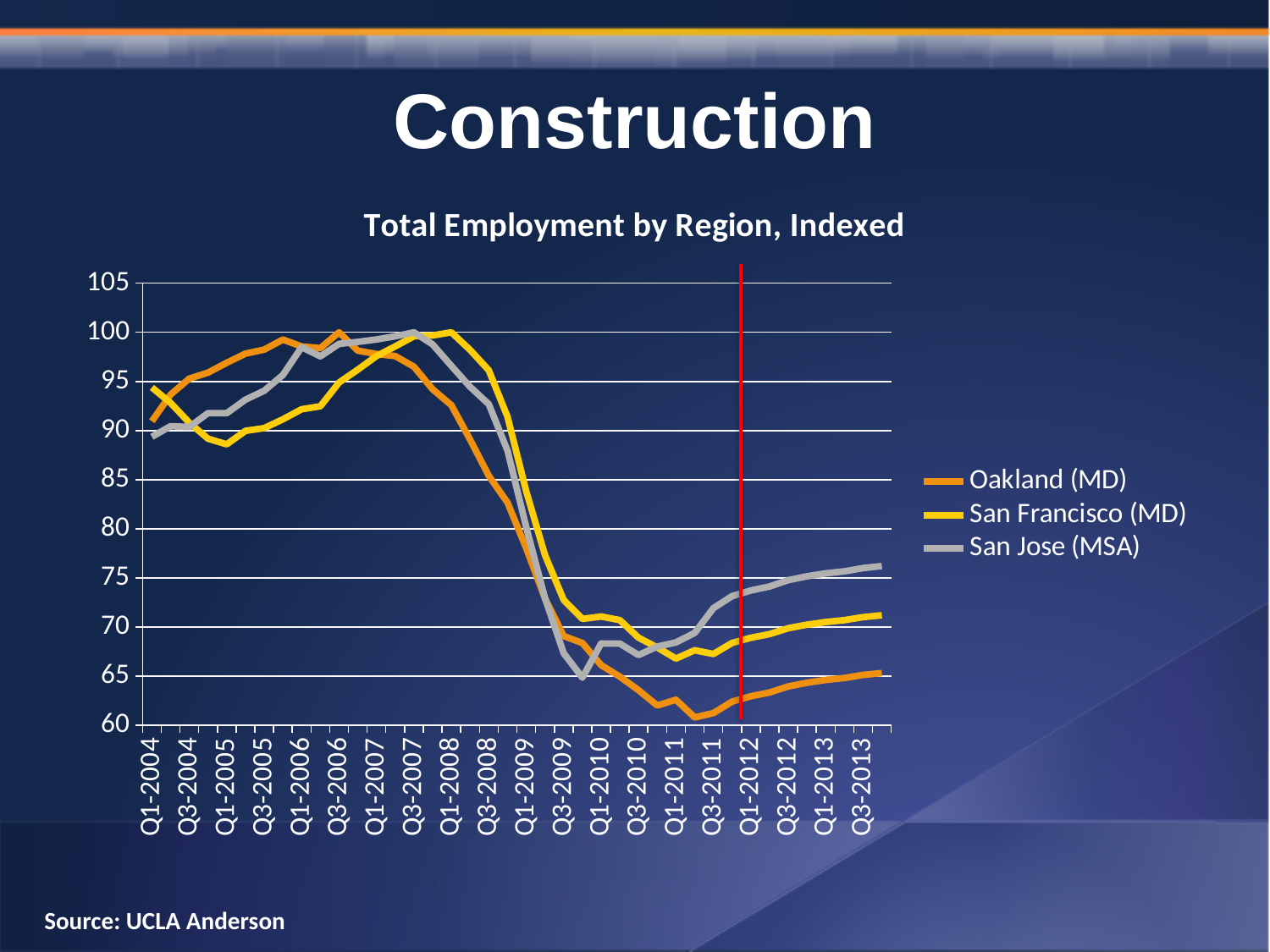
Which series is drawn in grey? San Jose (MSA) What kind of chart is shown on the slide? Line chart Which series has the lowest value at Q3-2013? Oakland (MD) Is the value for Oakland (MD) at Q3-2005 greater or less than 95? greater Does the San Francisco (MD) line rise or fall between Q1-2008 and Q1-2010? Fall Is the value for Oakland (MD) at Q1-2011 greater or less than 65? less How many series does the legend list? 3 What is the title of the chart? Total Employment by Region, Indexed How many quarter labels are shown on the x axis? 20 Is the value for San Francisco (MD) at Q1-2005 greater or less than 90? less At Q3-2013, which series has the higher value, San Jose (MSA) or Oakland (MD)? San Jose (MSA)